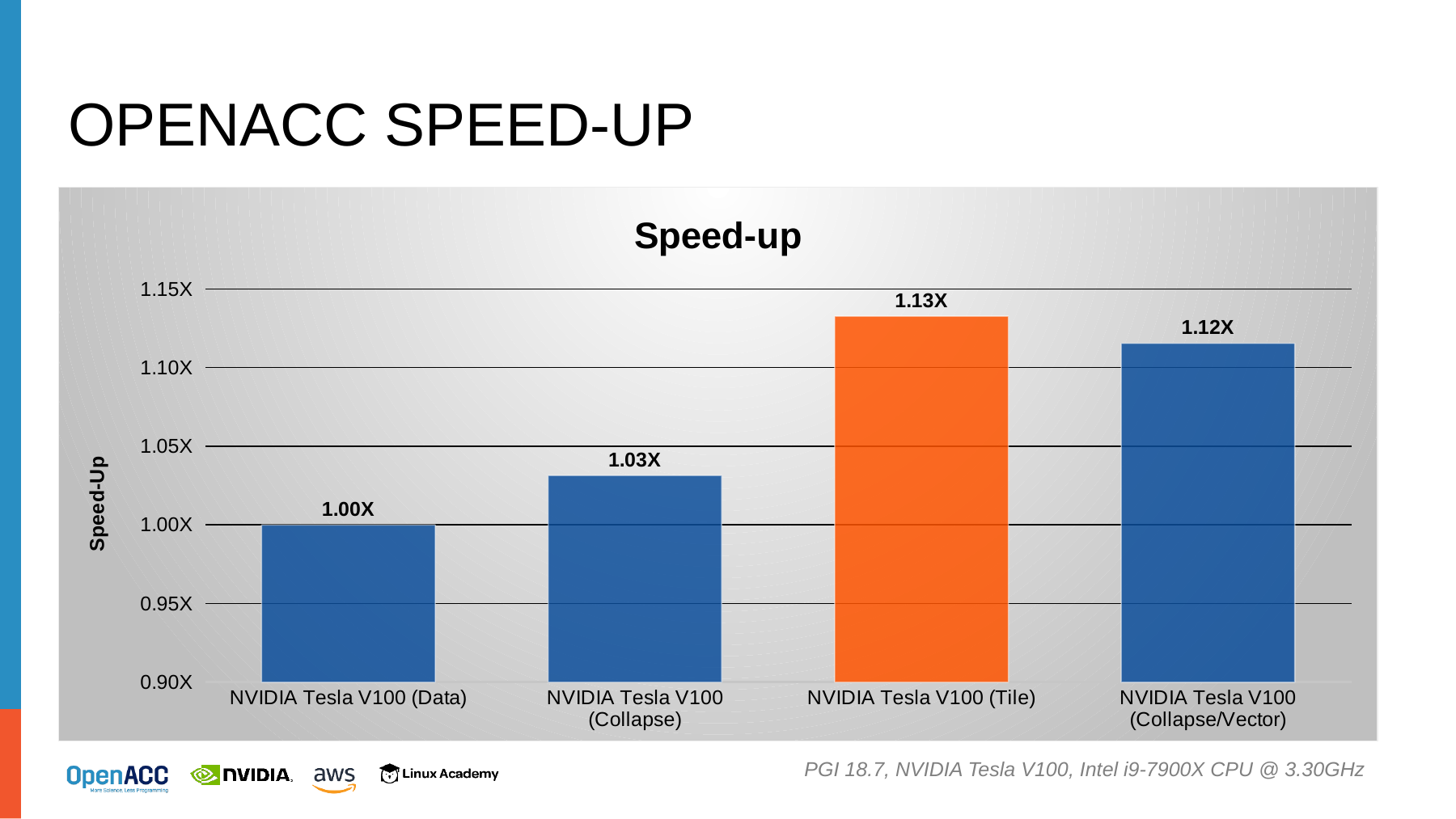
What is the speed-up value for NVIDIA Tesla V100 (Data)? 1.00X What is the difference between the speed-up for NVIDIA Tesla V100 (Tile) and NVIDIA Tesla V100 (Data)? 0.13X Which category has the highest speed-up? NVIDIA Tesla V100 (Tile) What is the title of the chart? Speed-up Is the speed-up for NVIDIA Tesla V100 (Tile) greater or less than 1.10X? greater What is the speed-up value for NVIDIA Tesla V100 (Collapse)? 1.03X Which category has the lowest speed-up? NVIDIA Tesla V100 (Data) What is the speed-up value for NVIDIA Tesla V100 (Tile)? 1.13X Which is larger, the speed-up for NVIDIA Tesla V100 (Collapse) or NVIDIA Tesla V100 (Collapse/Vector)? NVIDIA Tesla V100 (Collapse/Vector) What is the speed-up value for NVIDIA Tesla V100 (Collapse/Vector)? 1.12X How many categories are shown in the chart? 4 What kind of chart is shown on the slide? bar chart